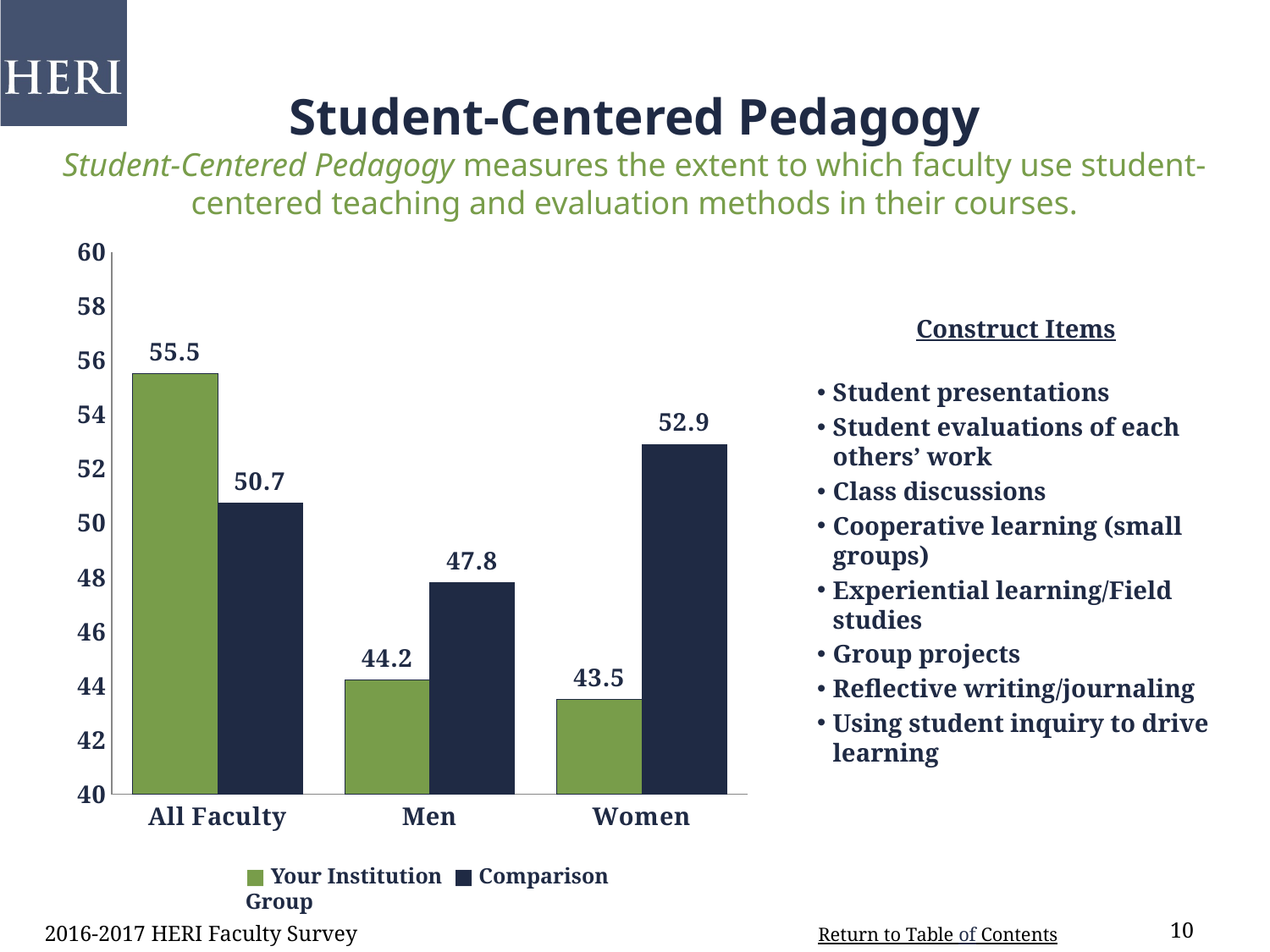
What kind of chart is shown on the slide? Bar chart For Men, which is larger: Your Institution or the Comparison Group? Comparison Group What is the value for Your Institution for Men? 44.2 Which category has the lowest Your Institution value? Women What is the difference between Your Institution and the Comparison Group for All Faculty? 4.8 What is the value for Your Institution for All Faculty? 55.5 How many categories are shown on the x axis? 3 How many series does the legend list? 2 Which category has the highest Comparison Group value? Women What is the value for the Comparison Group for Women? 52.9 What colour are the Comparison Group bars? Dark navy blue What is the difference between the Comparison Group and Your Institution for Women? 9.4